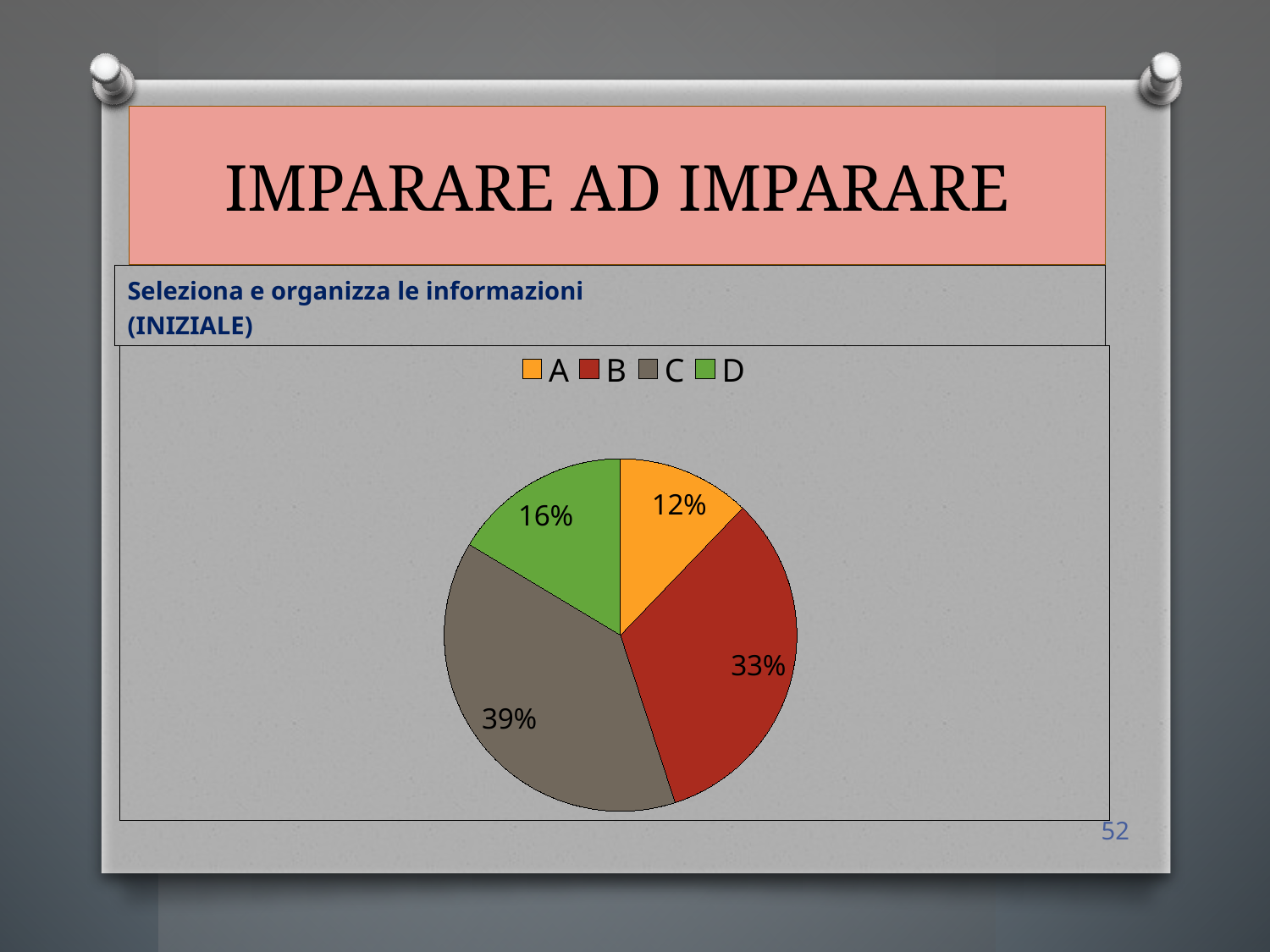
How many slices does the pie chart have? 4 What kind of chart is shown on the slide? pie chart What colour is the slice for category D? green Which category has the smallest slice of the pie? A Which is larger, the slice for B or the slice for D? B What share of the pie does category D have? 16% What is the difference in percentage points between category C and category B? 6 How many categories does the legend list? 4 What share of the pie does category A have? 12% What share of the pie does category B have? 33% Which category has the largest slice of the pie? C